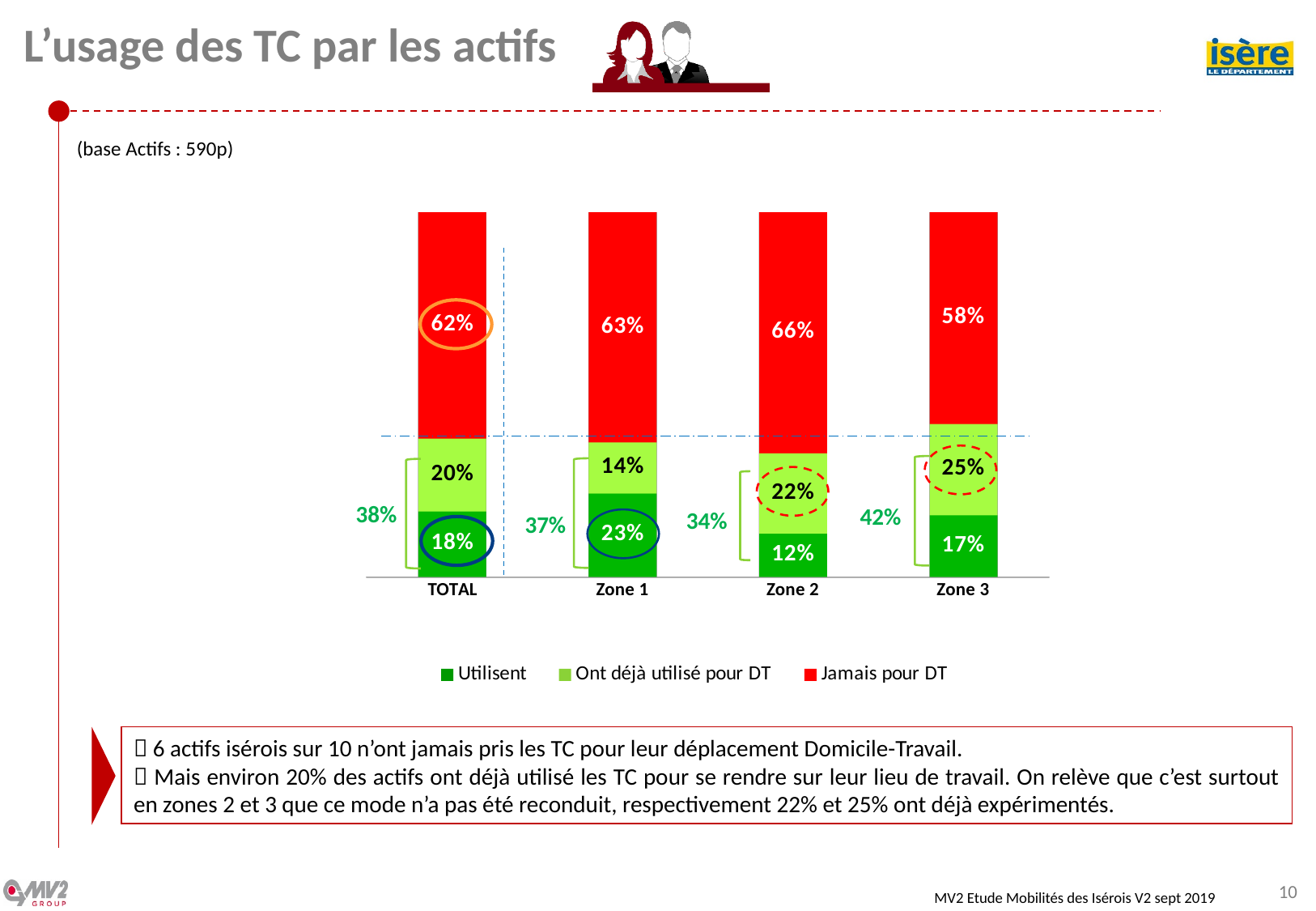
What is the difference between the "Ont déjà utilisé pour DT" values for Zone 3 and Zone 1? 11% Which category has the lowest value for "Utilisent"? Zone 2 What kind of chart is shown on the slide? Stacked bar chart Which is larger: the "Utilisent" value for Zone 1 or for Zone 3? Zone 1 How many categories are shown on the x axis? 4 What is the value of "Ont déjà utilisé pour DT" for Zone 3? 25% Which category has the highest value for "Jamais pour DT"? Zone 2 What is the combined total of "Utilisent" and "Ont déjà utilisé pour DT" for Zone 2? 34% What is the value of "Utilisent" for Zone 1? 23% What is the value of "Jamais pour DT" for Zone 2? 66% What is the value of "Utilisent" for TOTAL? 18% How many series does the legend list? 3